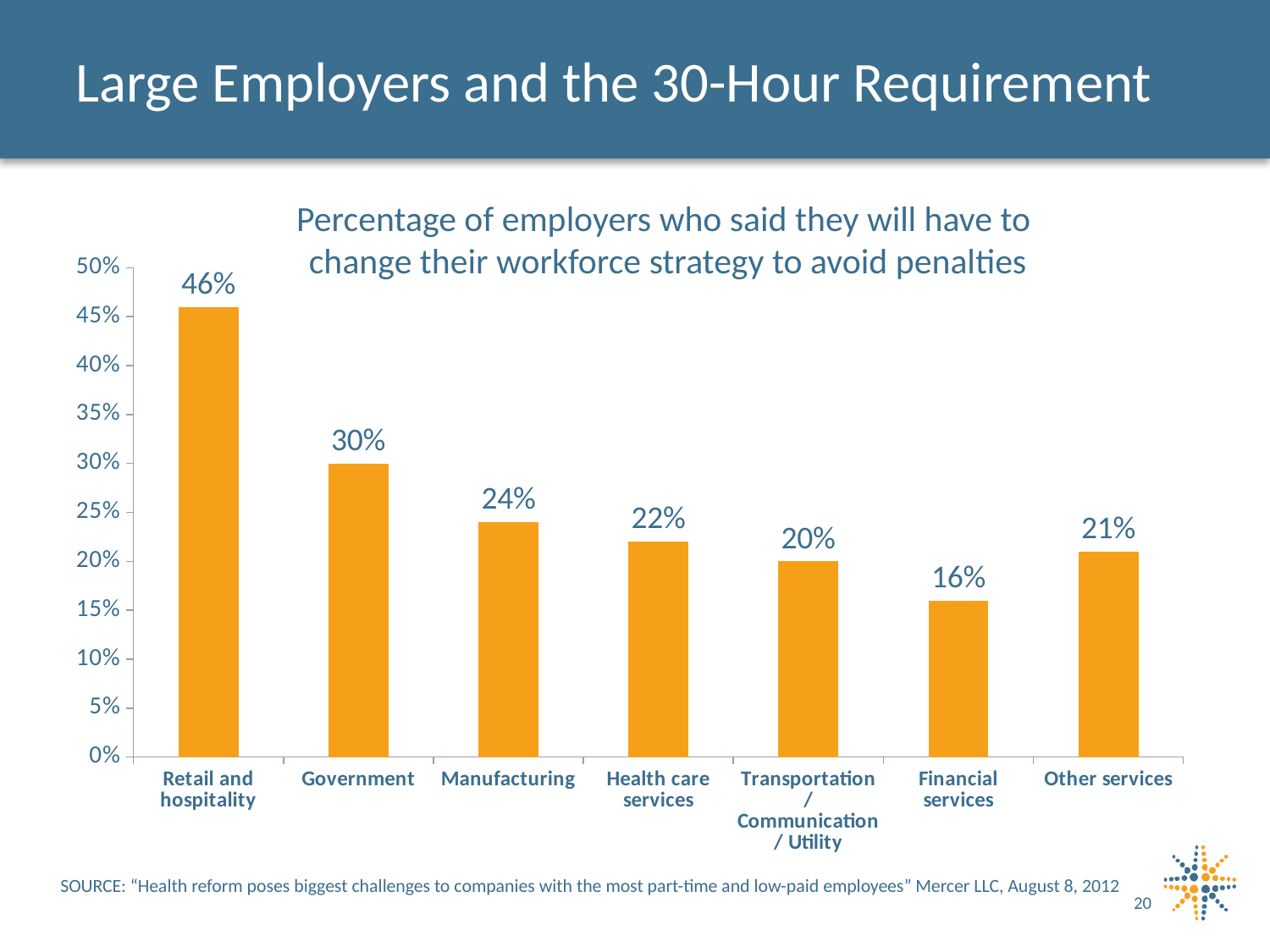
What is the title of the chart? Percentage of employers who said they will have to change their workforce strategy to avoid penalties What is the value shown for Financial services? 16% What is the difference between the values for Retail and hospitality and Government? 16% Which industry has the lowest percentage? Financial services What kind of chart is shown on the slide? Bar chart What is the value shown for Transportation / Communication / Utility? 20% What is the value shown for Government? 30% What percentage of Retail and hospitality employers said they will have to change their workforce strategy to avoid penalties? 46% How many industry categories are shown on the chart? 7 Which industry has the highest percentage of employers who said they will have to change their workforce strategy? Retail and hospitality Which is larger, the value for Other services or the value for Transportation / Communication / Utility? Other services What is the difference between the values for Manufacturing and Health care services? 2%